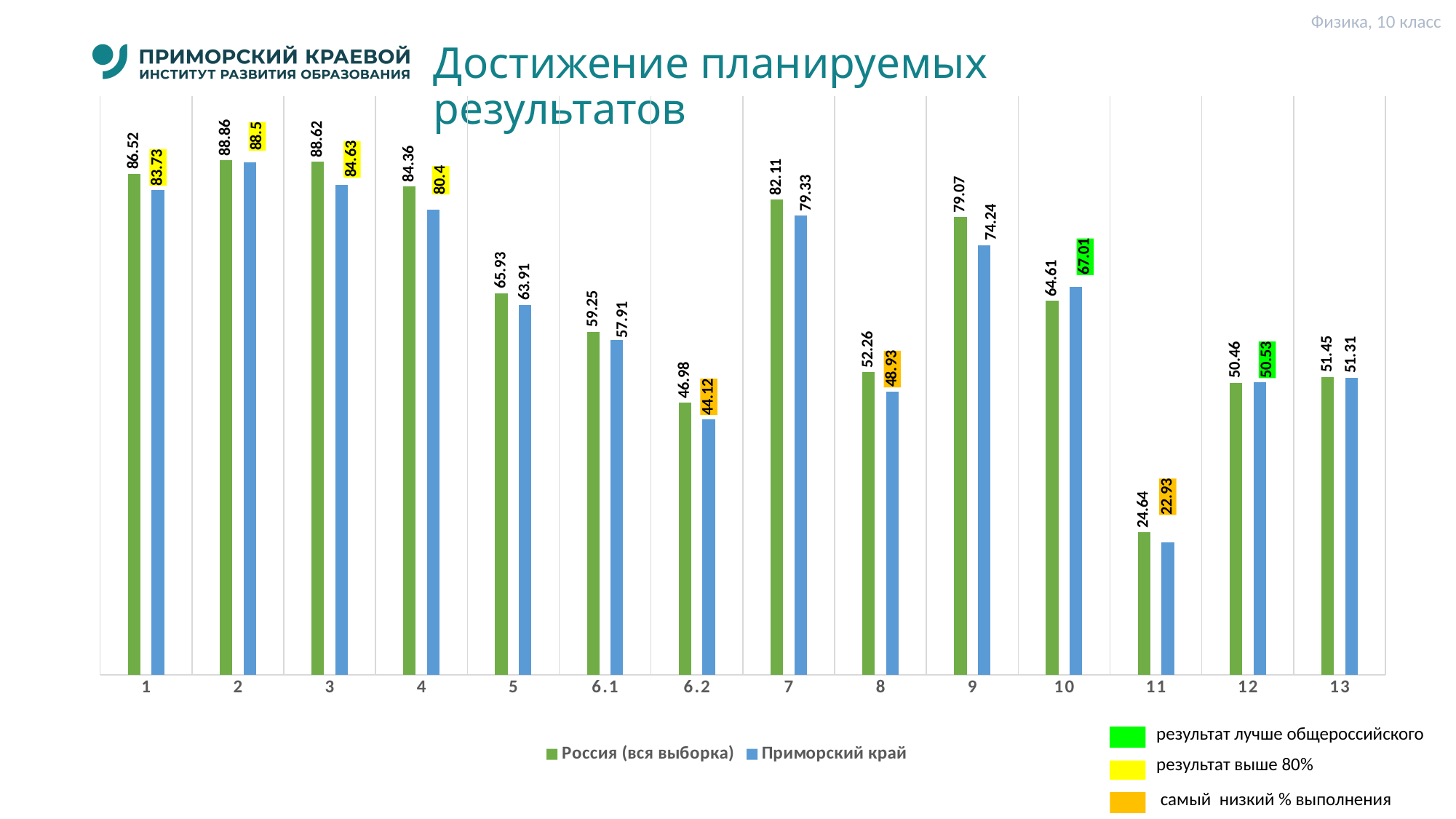
For task 12, which series has the larger value: Россия (вся выборка) or Приморский край? Приморский край How many series does the chart legend list? 2 How many task categories are shown on the x axis? 14 What is the value for Приморский край for task 2? 88.5 For task 7, which series has the larger value: Россия (вся выборка) or Приморский край? Россия (вся выборка) What is the difference between Россия (вся выборка) and Приморский край for task 9? 4.83 Which task has the lowest value for Россия (вся выборка)? 11 What kind of chart is shown on the slide? bar chart What is the difference between Приморский край and Россия (вся выборка) for task 10? 2.4 Which task has the highest value for Приморский край? 2 What is the value for Россия (вся выборка) for task 11? 24.64 What is the value for Приморский край for task 6.2? 44.12